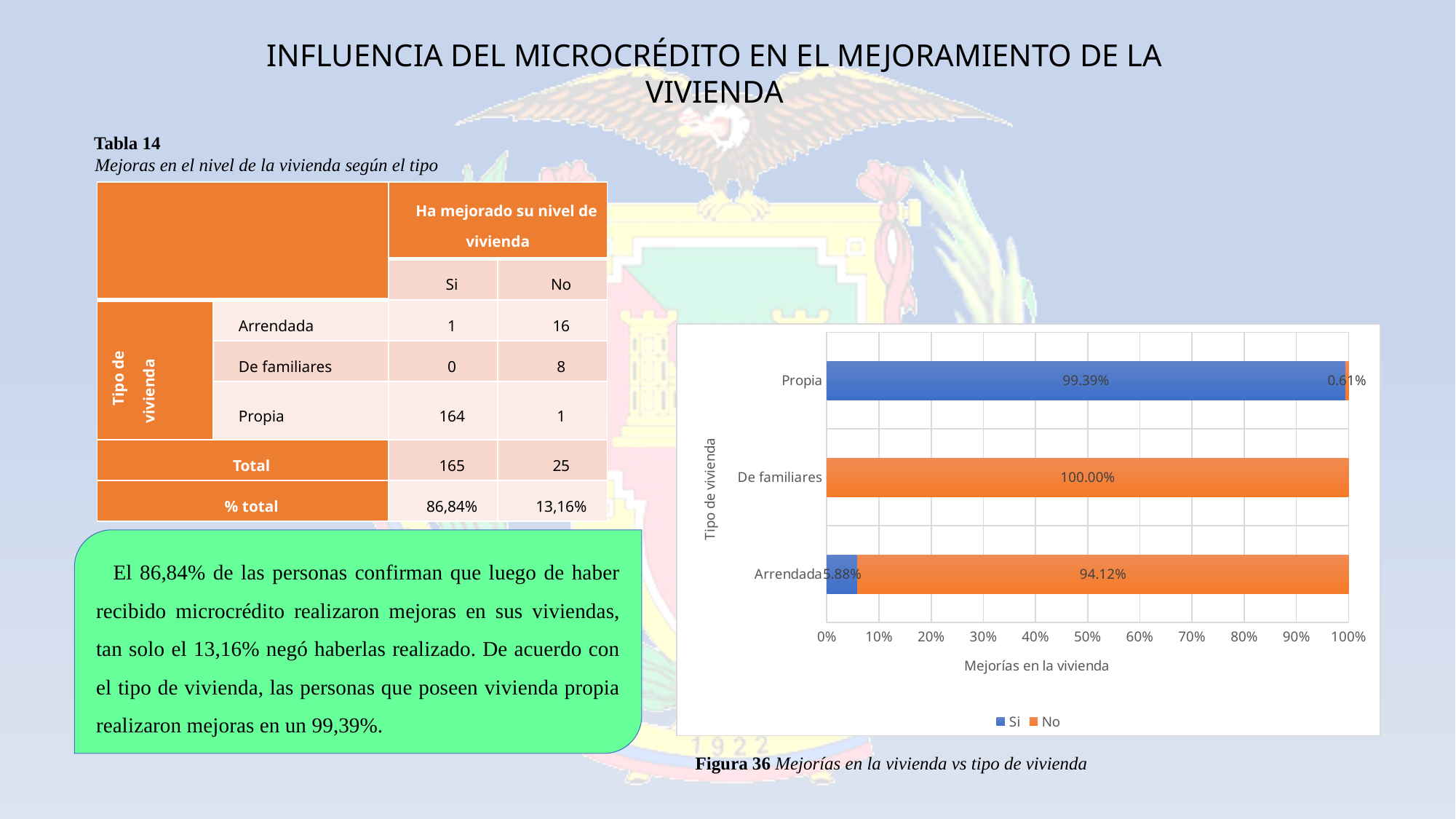
What is the value of the No series for Arrendada in the chart? 94.12% How many housing-type categories are plotted on the chart's vertical axis? 3 What kind of chart is shown in Figura 36? bar chart In the chart, what is the difference between the No value for Arrendada and the Si value for Arrendada? 88.24% What is the value of the No series for Propia in the chart? 0.61% Which series is shown in blue in the chart's legend? Si What is the value of the No series for De familiares in the chart? 100.00% How many series does the legend of the chart list? 2 What is the value of the Si series for Arrendada in the chart? 5.88% Which housing type has the highest Si value in the chart? Propia What is the value of the Si series for Propia in the chart? 99.39% Which housing type has the lowest No value in the chart? Propia